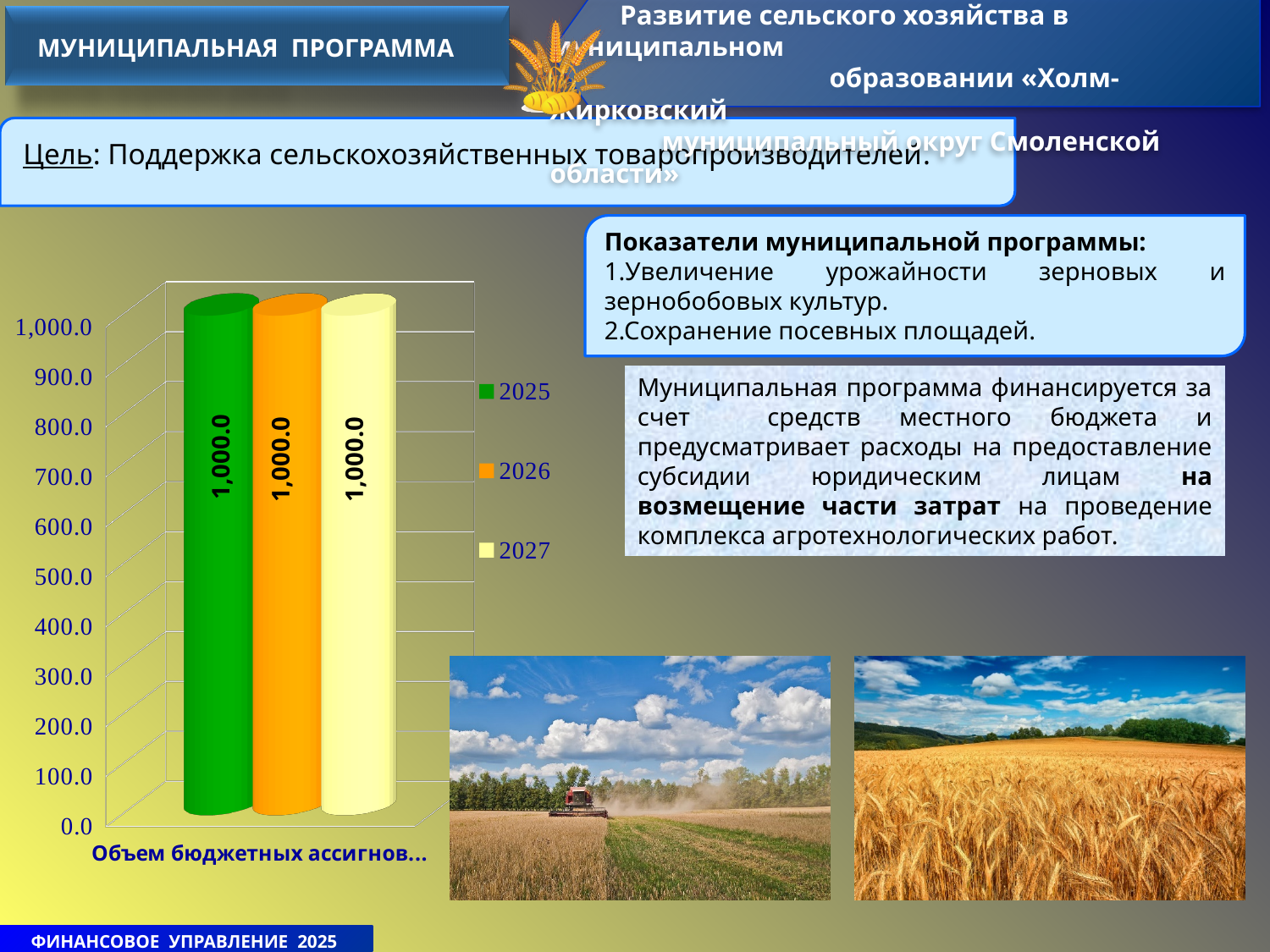
How many series does the chart legend list? 3 Is the value for 2026 greater or less than 500.0? greater What is the value for the 2026 series in the chart? 1,000.0 What is the highest value shown on the chart's vertical axis? 1,000.0 Do the values change from 2025 to 2027, or stay the same? stay the same How many categories are shown on the x axis of the chart? 1 What is the value for the 2027 series in the chart? 1,000.0 Which series is shown in orange in the chart legend? 2026 Which series is shown in green in the chart legend? 2025 What kind of chart is shown on the slide? bar chart What is the difference between the values for 2025 and 2027? 0.0 What is the value for the 2025 series in the chart? 1,000.0